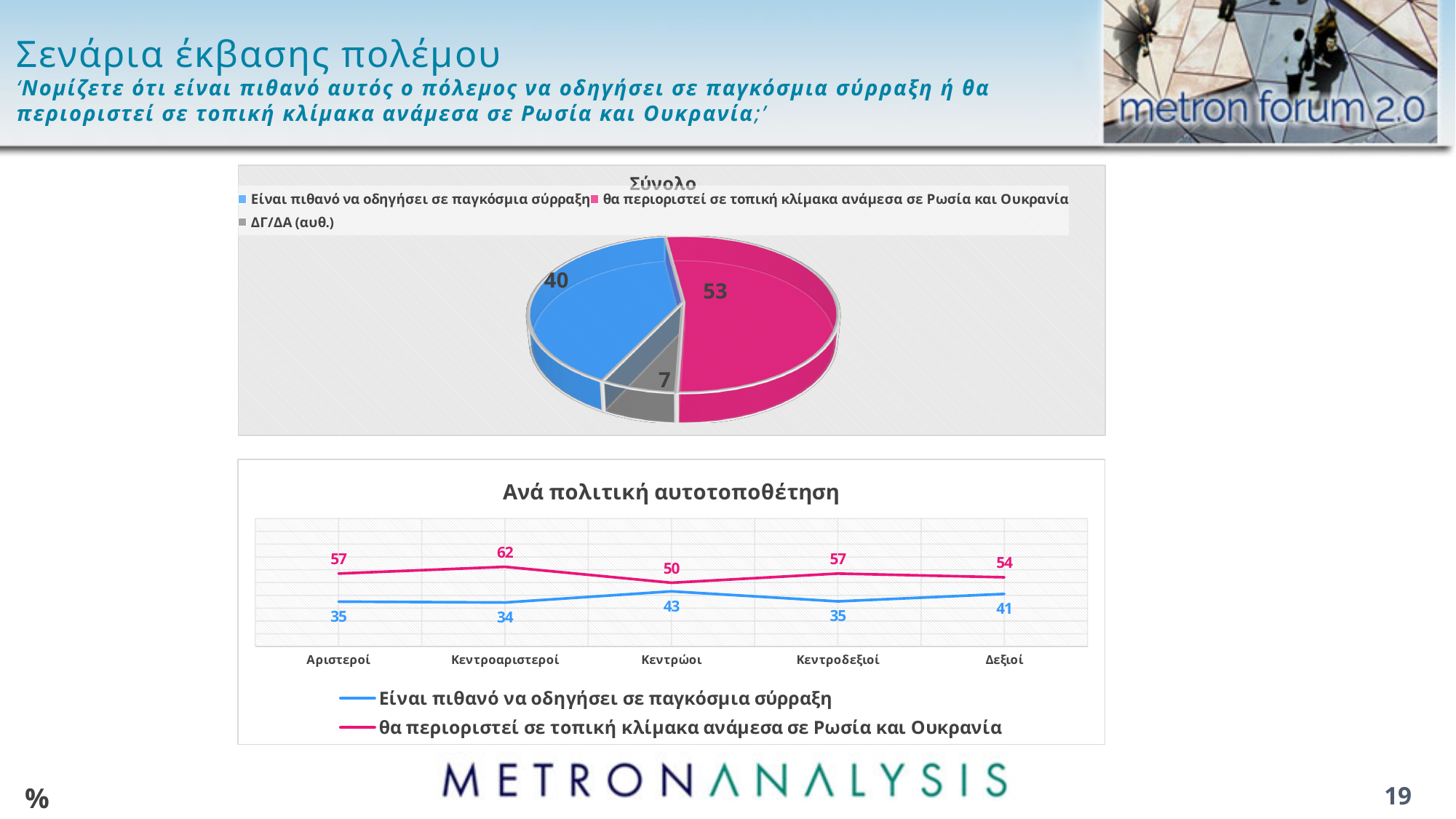
In the pie chart titled 'Σύνολο', how many slices are there? 3 In the pie chart titled 'Σύνολο', what is the value for 'θα περιοριστεί σε τοπική κλίμακα ανάμεσα σε Ρωσία και Ουκρανία'? 53 What kind of chart is the upper chart titled 'Σύνολο'? Pie chart In the line chart titled 'Ανά πολιτική αυτοτοποθέτηση', what is the value for 'Δεξιοί' in the series 'Είναι πιθανό να οδηγήσει σε παγκόσμια σύρραξη'? 41 In the pie chart titled 'Σύνολο', what is the difference between the value for 'θα περιοριστεί σε τοπική κλίμακα ανάμεσα σε Ρωσία και Ουκρανία' and the value for 'Είναι πιθανό να οδηγήσει σε παγκόσμια σύρραξη'? 13 In the pie chart titled 'Σύνολο', what is the value for 'ΔΓ/ΔΑ (αυθ.)'? 7 In the line chart titled 'Ανά πολιτική αυτοτοποθέτηση', which category has the lowest value in the series 'θα περιοριστεί σε τοπική κλίμακα ανάμεσα σε Ρωσία και Ουκρανία'? Κεντρώοι In the line chart titled 'Ανά πολιτική αυτοτοποθέτηση', what is the value for 'Κεντροαριστεροί' in the series 'θα περιοριστεί σε τοπική κλίμακα ανάμεσα σε Ρωσία και Ουκρανία'? 62 In the line chart titled 'Ανά πολιτική αυτοτοποθέτηση', what is the difference between the two series for 'Κεντρώοι'? 7 In the line chart titled 'Ανά πολιτική αυτοτοποθέτηση', which category has the lowest value in the series 'Είναι πιθανό να οδηγήσει σε παγκόσμια σύρραξη'? Κεντροαριστεροί In the line chart titled 'Ανά πολιτική αυτοτοποθέτηση', how many series does the legend list? 2 In the pie chart titled 'Σύνολο', which category has the largest slice? θα περιοριστεί σε τοπική κλίμακα ανάμεσα σε Ρωσία και Ουκρανία